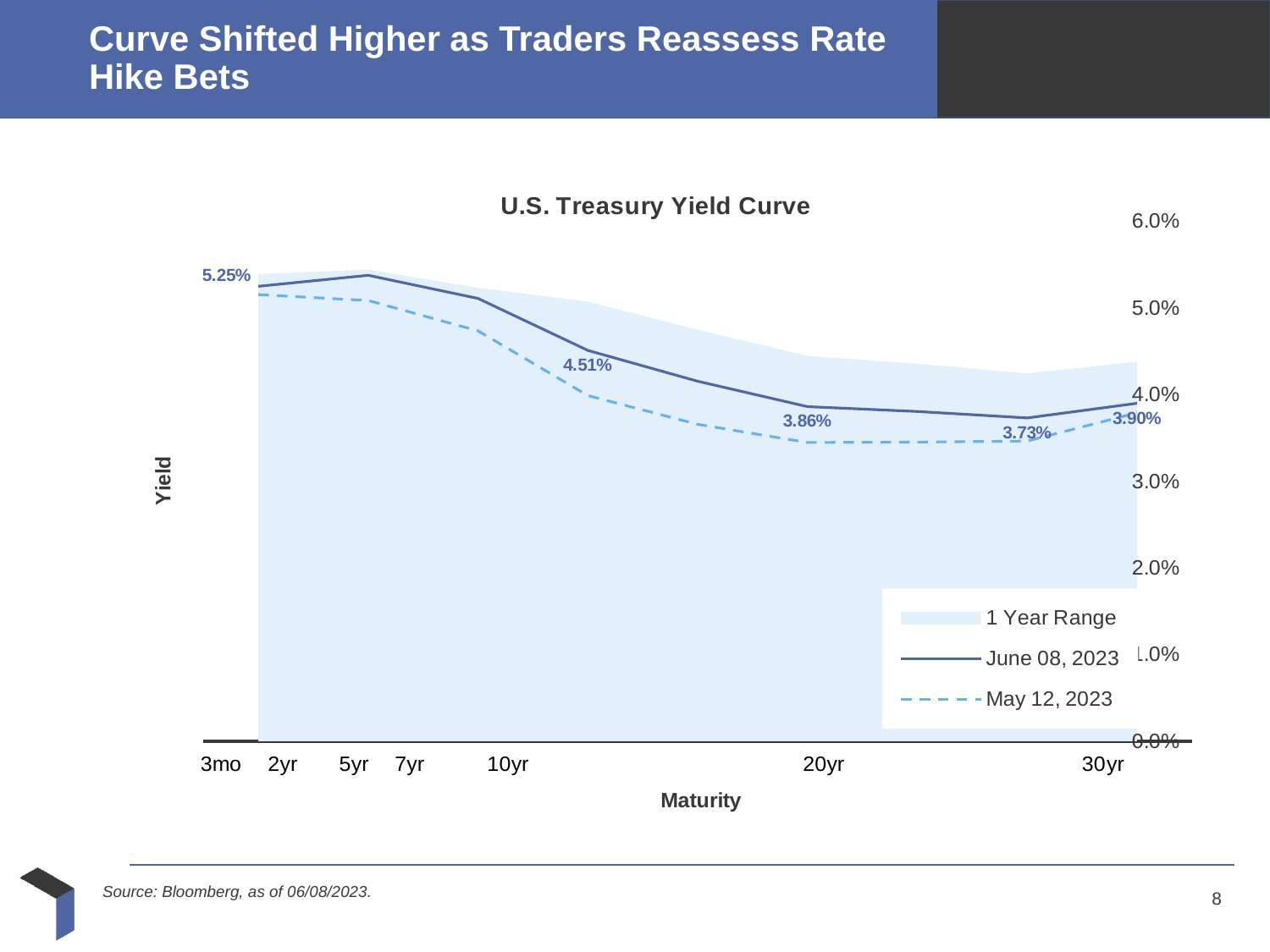
How many entries does the chart legend list? 3 What is the labeled yield for the June 08, 2023 curve at the 3mo maturity? 5.25% Which legend entry is drawn as a dashed line? May 12, 2023 What is the highest yield value labeled on the chart? 5.25% What kind of chart is shown on the slide? line chart What is the labeled yield for the June 08, 2023 curve at the 30yr maturity? 3.90% What is the labeled yield for the June 08, 2023 curve at the 20yr maturity? 3.86% What is the title of the chart? U.S. Treasury Yield Curve How many maturity labels are shown on the x axis? 7 What is the lowest yield value labeled on the chart? 3.73% Which curve is higher at the 10yr maturity, June 08, 2023 or May 12, 2023? June 08, 2023 Is the May 12, 2023 yield at the 20yr maturity greater or less than 4.0%? less